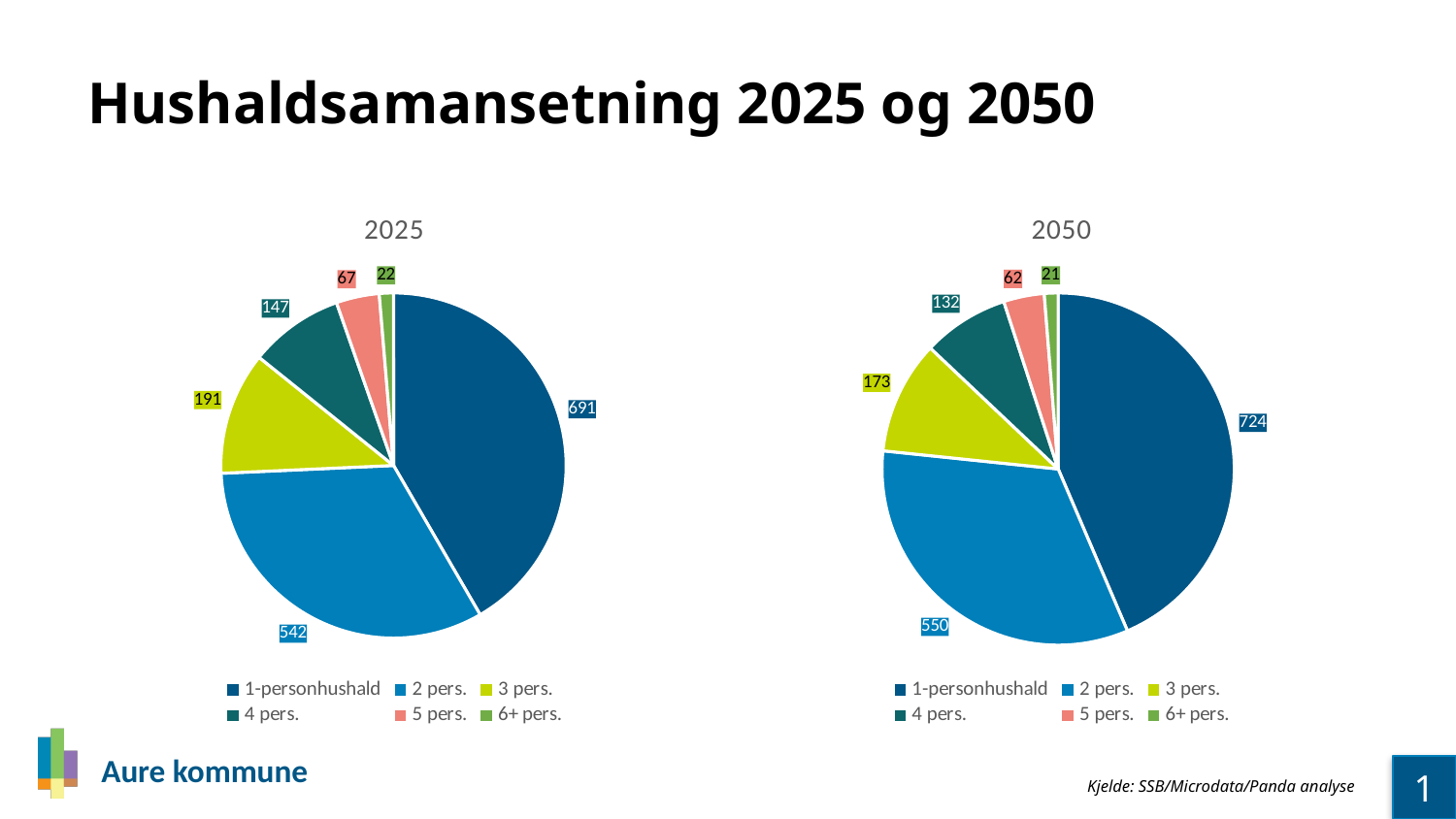
How many categories does the 2025 pie chart show? 6 What is the title of the left chart? 2025 In the 2050 pie chart, which category has the largest value? 1-personhushald In the 2050 pie chart, what is the difference between the values for 3 pers. and 4 pers.? 41 In the 2050 pie chart, what is the value for 6+ pers.? 21 What type of chart is used for the 2050 data? Pie chart In the 2025 pie chart, what is the value for 4 pers.? 147 In the 2025 pie chart, which category has the smallest value? 6+ pers. In the 2050 pie chart, what is the value for 2 pers.? 550 In the 2025 pie chart, what is the value for 1-personhushald? 691 In the 2025 pie chart, what is the difference between the values for 1-personhushald and 2 pers.? 149 Which is larger: the value for 3 pers. in the 2025 chart or the value for 3 pers. in the 2050 chart? 2025